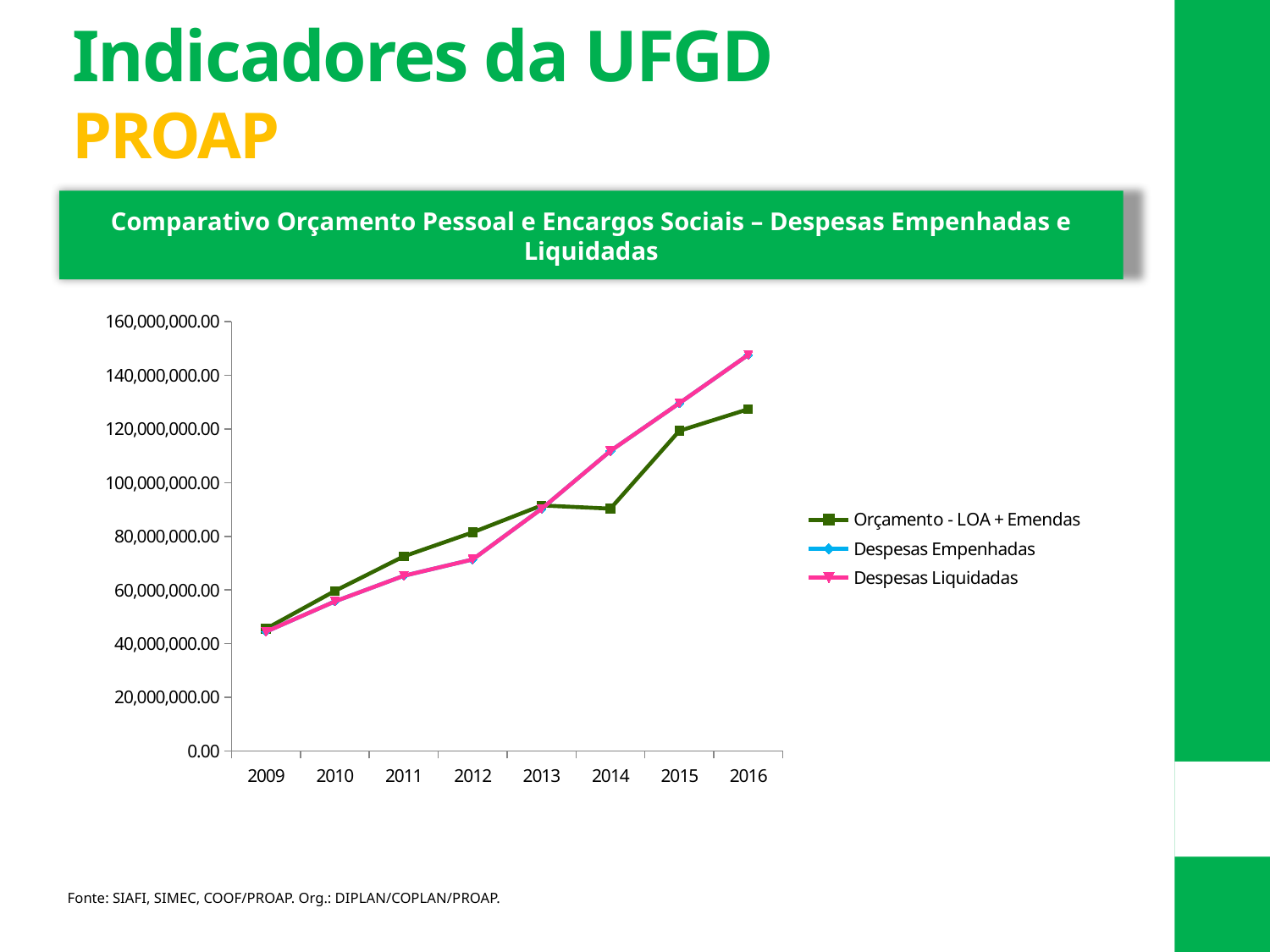
In which year is the value for Despesas Liquidadas lowest? 2009 Is the value for Despesas Liquidadas in 2016 greater or less than 140,000,000.00? greater Which series is shown in pink in the legend? Despesas Liquidadas How many years are plotted along the x axis? 8 What kind of chart is shown on the slide? Line chart How many series does the legend list? 3 In which year is the value for Orçamento - LOA + Emendas highest? 2016 What is the title shown above the chart? Comparativo Orçamento Pessoal e Encargos Sociais – Despesas Empenhadas e Liquidadas In 2016, which is larger: Orçamento - LOA + Emendas or Despesas Liquidadas? Despesas Liquidadas Is the value for Despesas Liquidadas in 2012 greater or less than 80,000,000.00? less Do the values for Despesas Liquidadas rise or fall from 2009 to 2016? Rise Is the value for Orçamento - LOA + Emendas in 2014 greater or less than 100,000,000.00? less